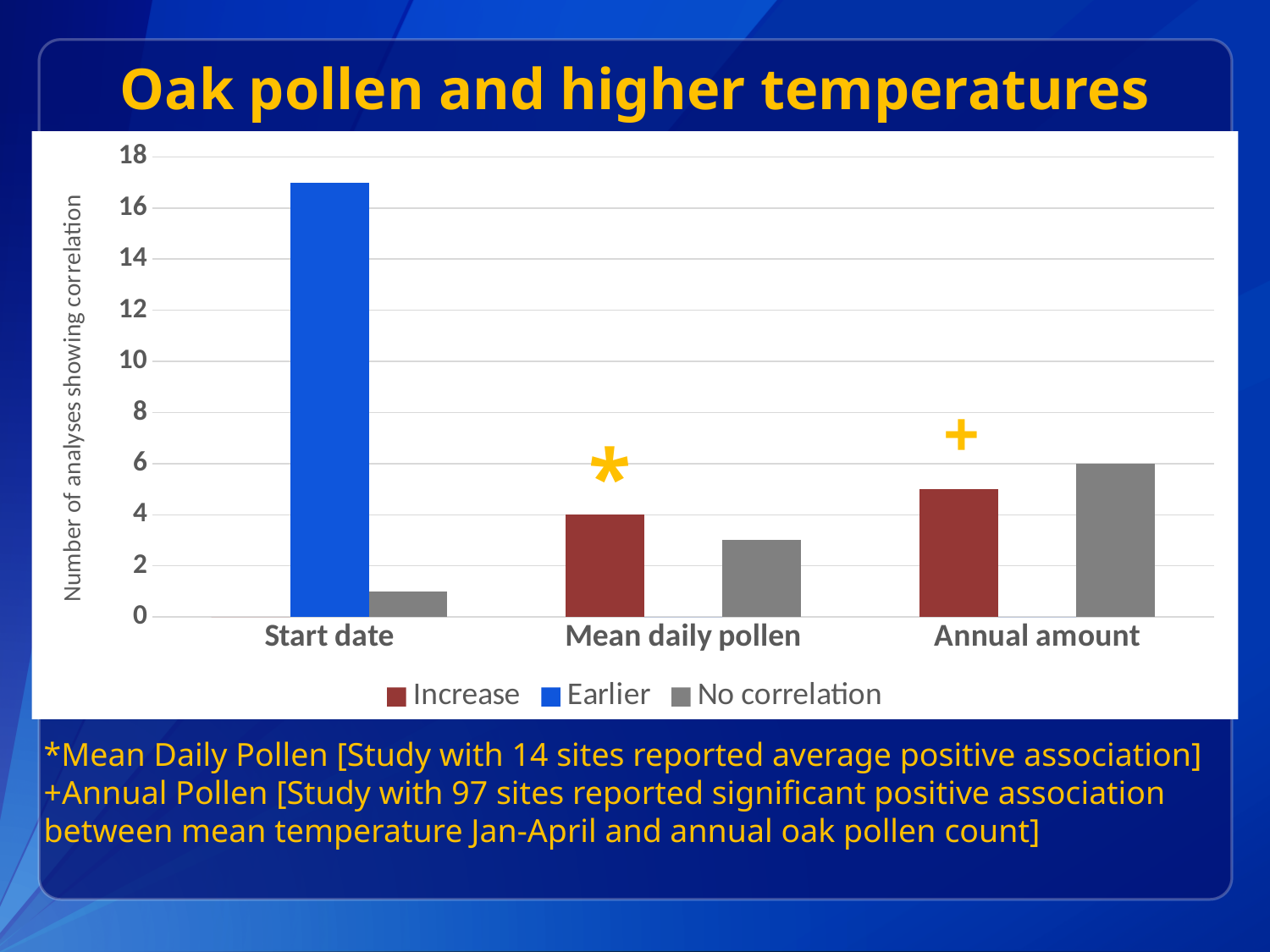
What kind of chart is shown on the slide? bar chart What is the label on the y axis of the chart? Number of analyses showing correlation Is the value of the Earlier bar for Start date greater or less than 16? greater How many categories are shown on the x axis? 3 What is the value of the Increase bar for Mean daily pollen? 4 What is the value of the No correlation bar for Annual amount? 6 Is the value of the No correlation bar for Start date greater or less than 2? less Is the value of the Increase bar for Annual amount greater or less than 4? greater For Annual amount, which is larger: the Increase bar or the No correlation bar? No correlation For Mean daily pollen, which is larger: the Increase bar or the No correlation bar? Increase Which bar is the tallest in the chart? Earlier for Start date How many series does the legend list? 3